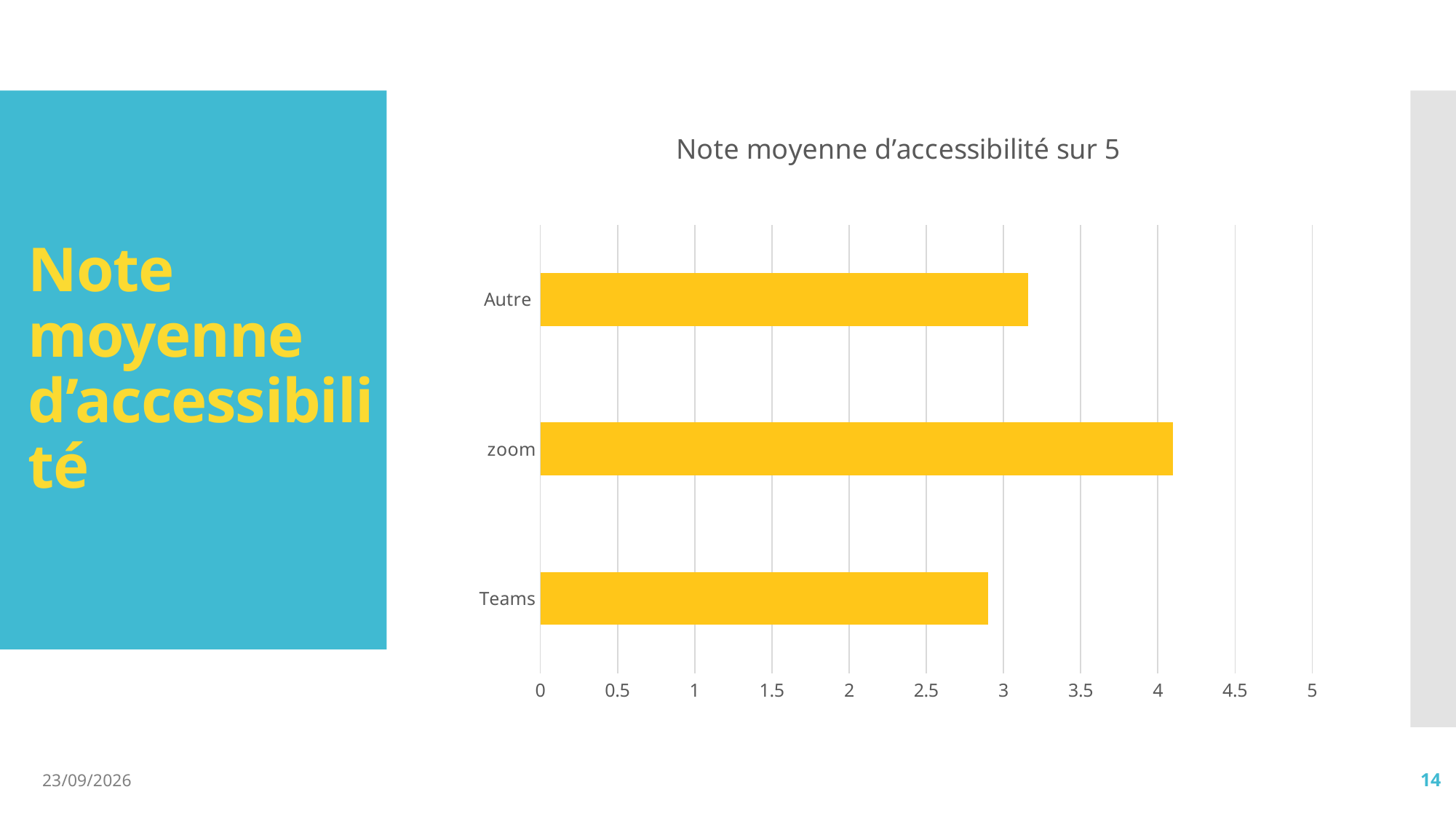
What kind of chart is shown on the slide? bar chart Is the value for zoom greater or less than 4.5? less Which category has the lowest average accessibility score? Teams Is the value for zoom greater or less than 3.5? greater Is the value for Autre greater or less than 3.5? less What is the title of the chart? Note moyenne d'accessibilité sur 5 Which has a higher value, Autre or Teams? Autre What colour are the bars in the chart? yellow Which category has the highest average accessibility score? zoom How many categories are plotted in the chart? 3